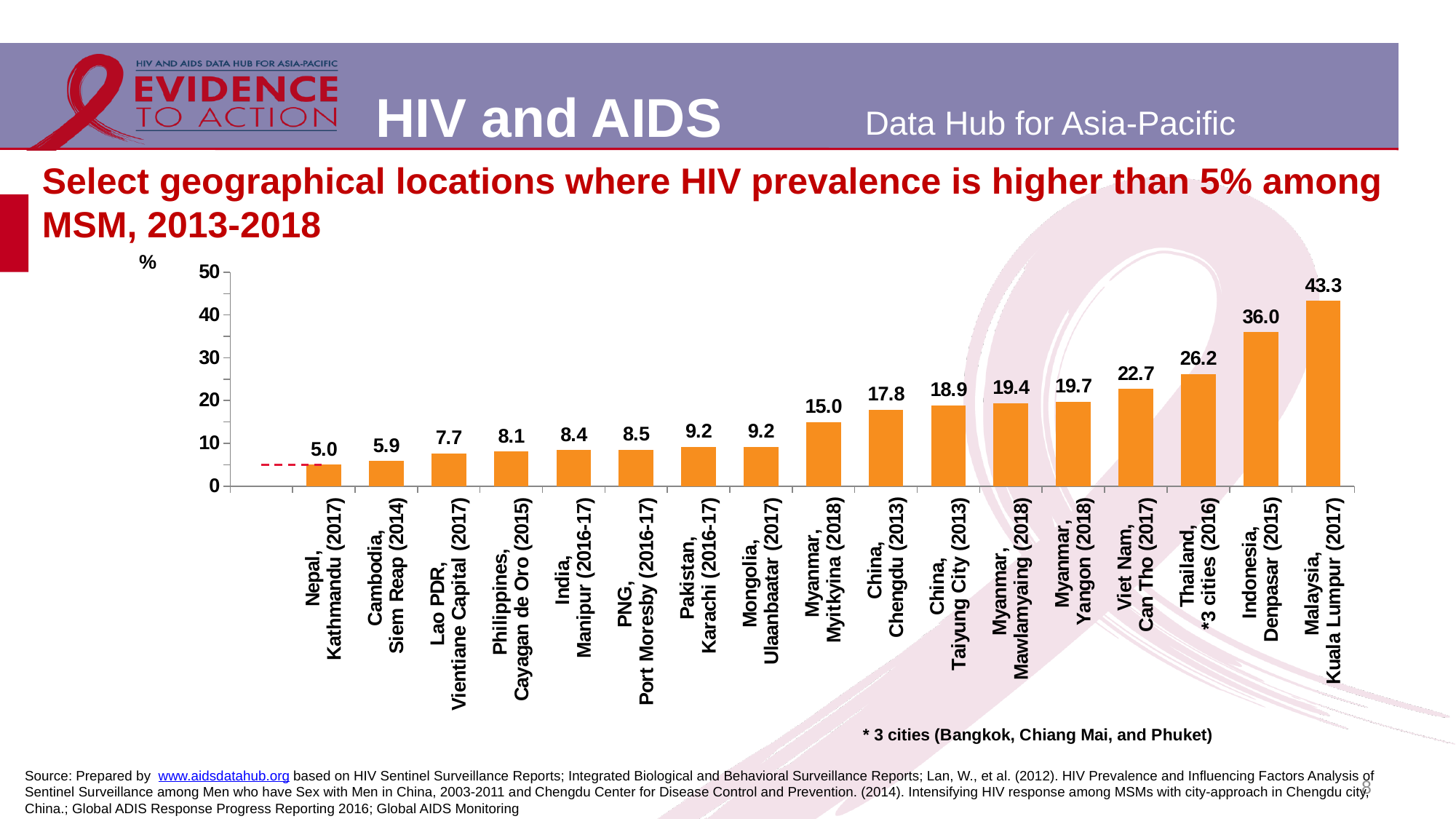
Which has a higher value: Myanmar, Yangon (2018) or China, Chengdu (2013)? Myanmar, Yangon (2018) What type of chart is shown on the slide? bar chart Which three cities does the asterisk for Thailand refer to? Bangkok, Chiang Mai, and Phuket Is the value for Myanmar, Myitkyina (2018) greater or less than 20? less Do the values rise or fall from left to right along the x axis? rise Which location has the lowest HIV prevalence in the chart? Nepal, Kathmandu (2017) What is the value shown for Lao PDR, Vientiane Capital (2017)? 7.7 What is the HIV prevalence value shown for Malaysia, Kuala Lumpur (2017)? 43.3 Which location has the highest HIV prevalence in the chart? Malaysia, Kuala Lumpur (2017) What is the value shown for Viet Nam, Can Tho (2017)? 22.7 What is the difference between the values for Indonesia, Denpasar (2015) and Thailand, 3 cities (2016)? 9.8 How many locations are plotted in the chart? 17